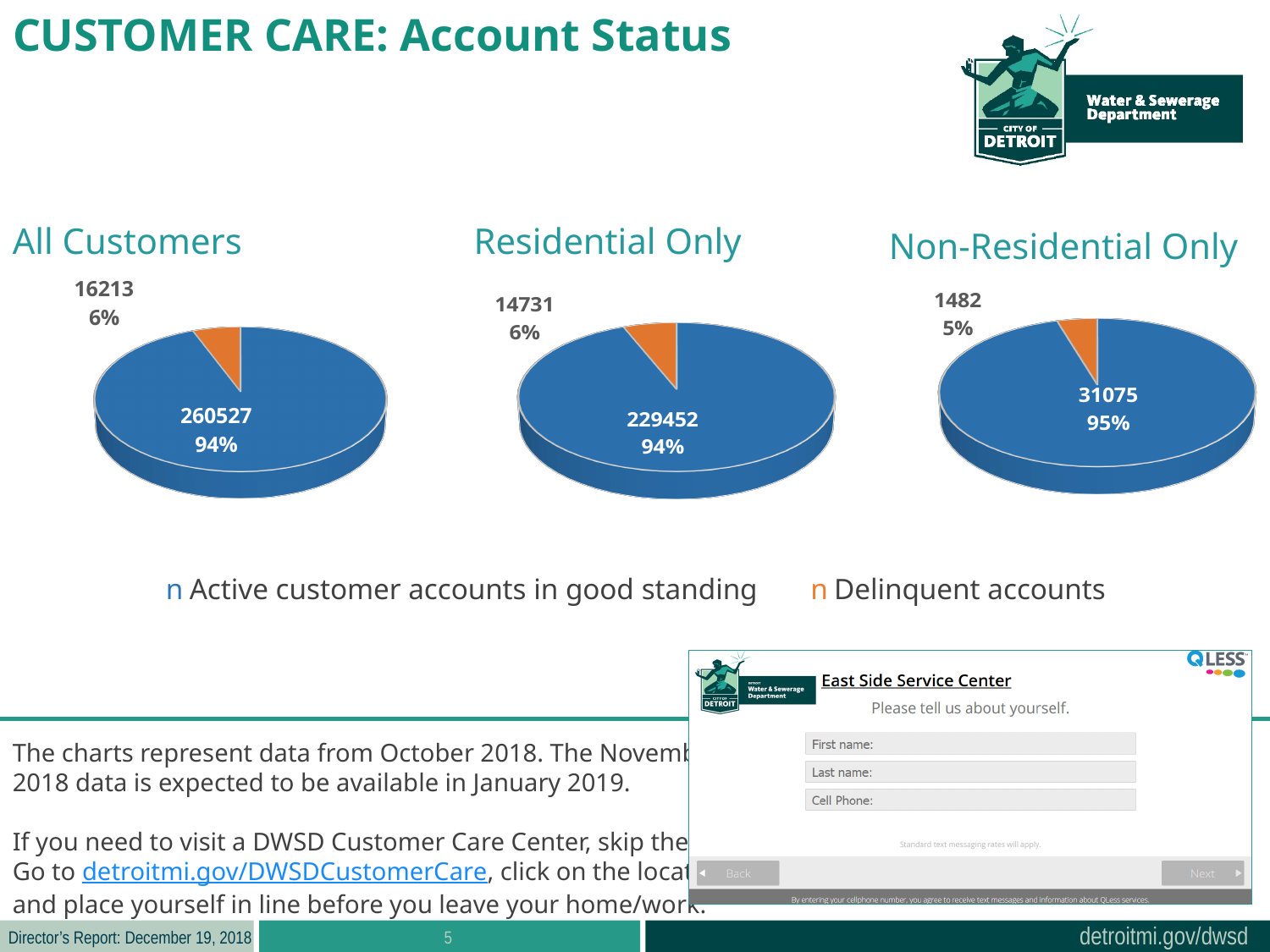
In the Non-Residential Only chart, what percentage of accounts are delinquent? 5% What type of chart is used for the Residential Only data? Pie chart How many categories does the legend list for the charts? 2 In the Non-Residential Only chart, how many active customer accounts are in good standing? 31075 In the Residential Only chart, what share of accounts are active accounts in good standing? 94% In the All Customers chart, what percentage of accounts are delinquent? 6% In the All Customers chart, how many active customer accounts are in good standing? 260527 In the Residential Only chart, how many delinquent accounts are there? 14731 In the Non-Residential Only chart, what is the difference between the number of active accounts in good standing and the number of delinquent accounts? 29593 In the All Customers chart, which category is larger: active accounts in good standing or delinquent accounts? Active customer accounts in good standing In the Residential Only chart, what is the total number of accounts across both categories? 244183 Which colour represents delinquent accounts in the charts? Orange